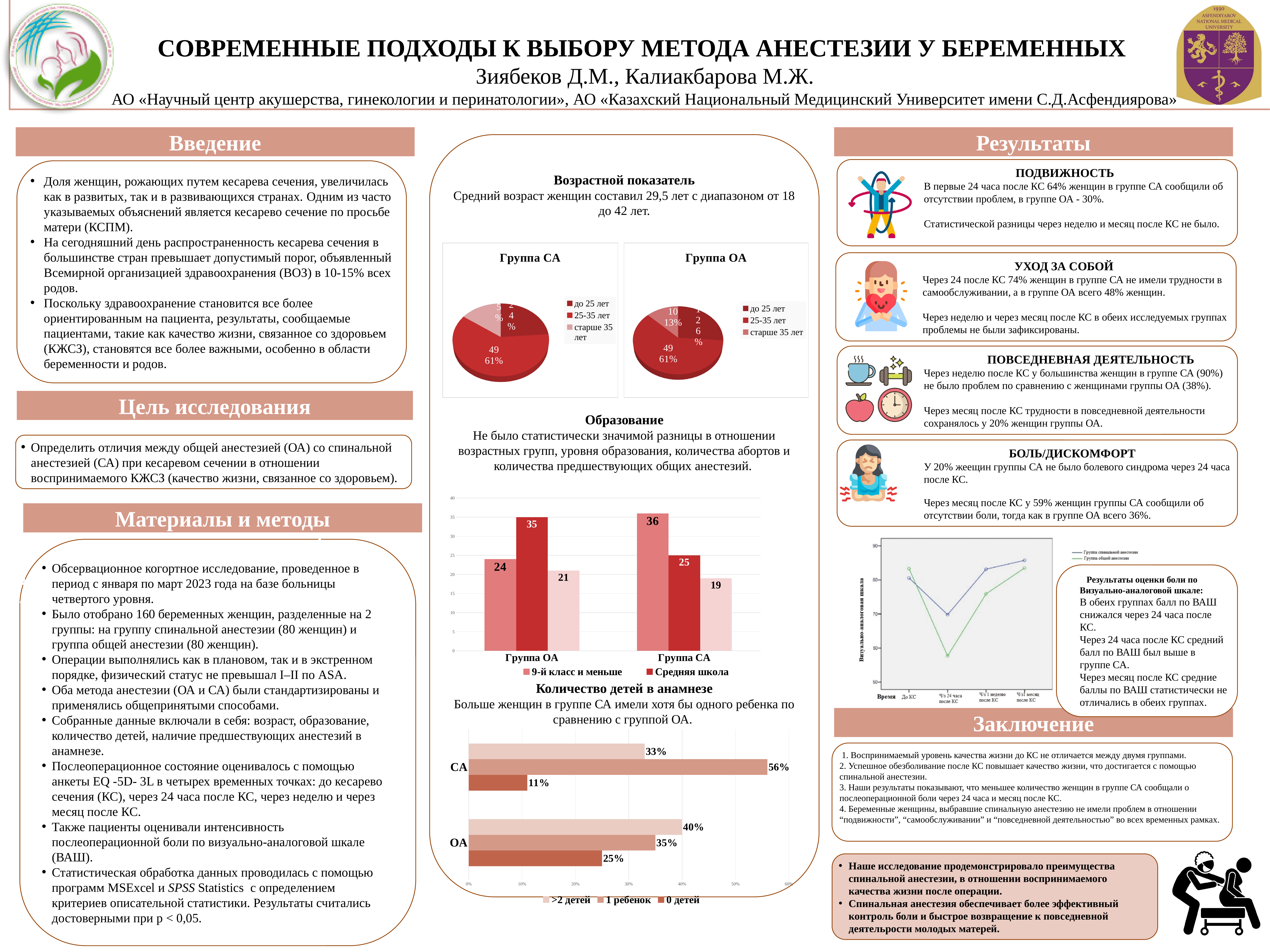
How many series does the legend of the 'Количество детей в анамнезе' chart list? 3 In the 'Количество детей в анамнезе' chart, what is the value of '0 детей' for ОА? 25% What type of chart is used for 'Количество детей в анамнезе'? Bar chart In the 'Образование' bar chart, what is the value of '9-й класс и меньше' for Группа СА? 36 In the 'Образование' bar chart, what is the value of 'Средняя школа' for Группа ОА? 35 How many slices does the 'Группа СА' pie chart have? 3 In the 'Количество детей в анамнезе' chart, what is the difference between the '0 детей' values for ОА and СА? 14% In the 'Образование' bar chart, what is the difference between the 'Средняя школа' values for Группа ОА and Группа СА? 10 In the 'Группа ОА' pie chart, what share does the largest slice have? 61% In the 'Количество детей в анамнезе' chart, what is the value of '1 ребенок' for СА? 56% In the 'Образование' bar chart, which group has the higher value for '9-й класс и меньше'? Группа СА In the 'Количество детей в анамнезе' chart, which group has the higher value for '>2 детей'? ОА